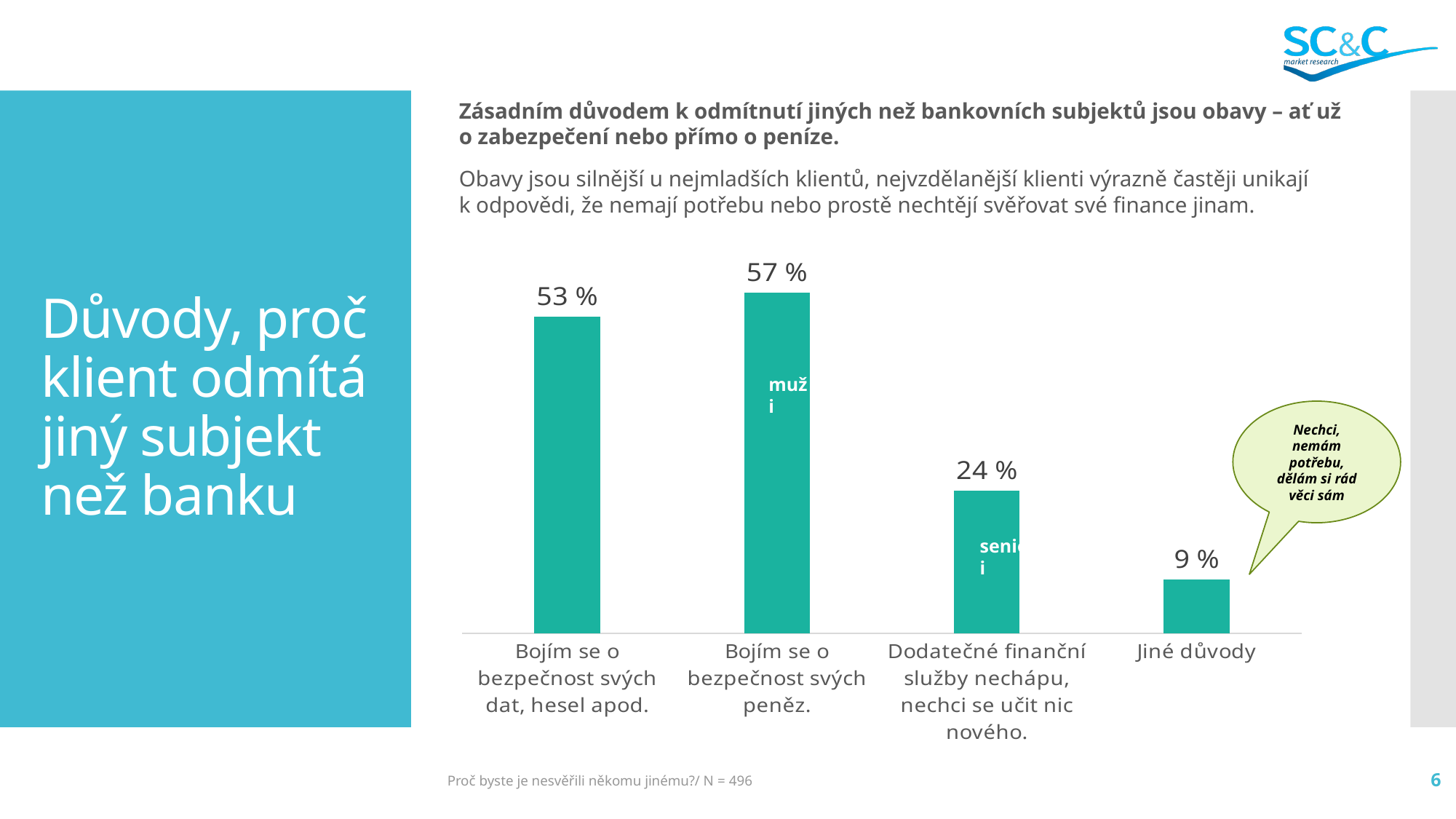
What is the value for "Jiné důvody"? 9 % What kind of chart is shown on the slide? bar chart What is the value for "Dodatečné finanční služby nechápu, nechci se učit nic nového."? 24 % Which category has the lowest value? Jiné důvody How many categories (bars) does the chart show? 4 From the second bar to the last bar, do the values rise or fall? fall What is the difference between the values for "Bojím se o bezpečnost svých peněz." and "Bojím se o bezpečnost svých dat, hesel apod."? 4 % What text is written in the speech bubble next to the "Jiné důvody" bar? Nechci, nemám potřebu, dělám si rád věci sám What is the value for "Bojím se o bezpečnost svých peněz."? 57 % Which is larger: the value for "Dodatečné finanční služby nechápu, nechci se učit nic nového." or the value for "Jiné důvody"? Dodatečné finanční služby nechápu, nechci se učit nic nového. What is the value for "Bojím se o bezpečnost svých dat, hesel apod."? 53 % Which category has the highest value? Bojím se o bezpečnost svých peněz.